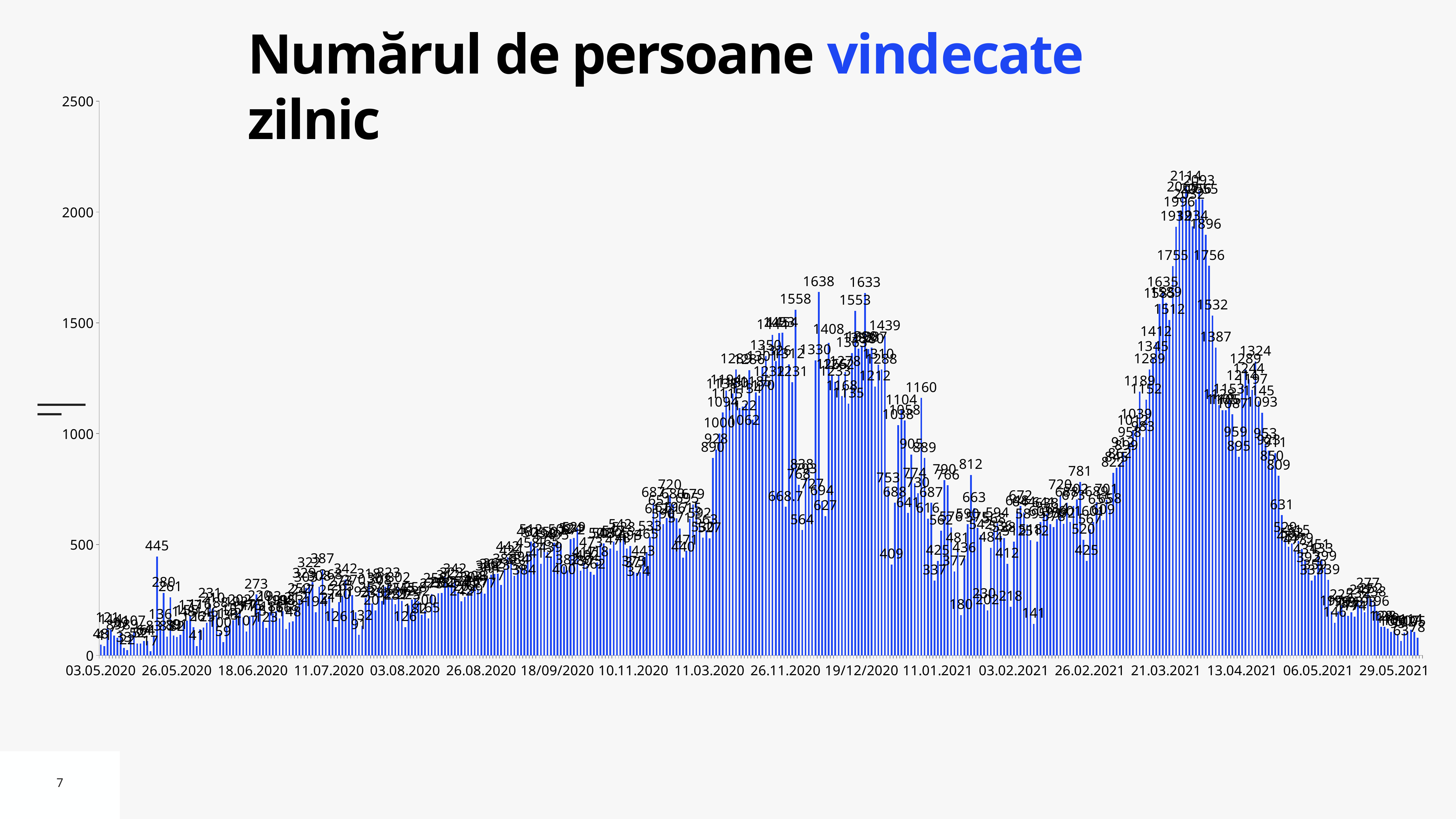
Is the value of the first bar, at 03.05.2020, greater or less than 500? less What is the title of the chart? Numărul de persoane vindecate zilnic Is the tallest bar on the chart greater or less than 2000? greater Do the values rise or fall between 13.04.2021 and 29.05.2021? fall How many date labels are shown along the horizontal axis? 18 What is the highest tick value shown on the vertical axis? 2500 What is the highest value labeled on the chart? 2114 What is the value of the tallest bar in the first wave, near 26.05.2020? 445 What kind of chart is shown on the slide? bar chart What is the highest labeled value in the late-2020 wave, near 26.11.2020? 1638 What is the difference between the overall peak value (2114) and the late-2020 peak value (1638)? 476 Which peak is higher: the one near 26.11.2020 or the one near 21.03.2021? the one near 21.03.2021